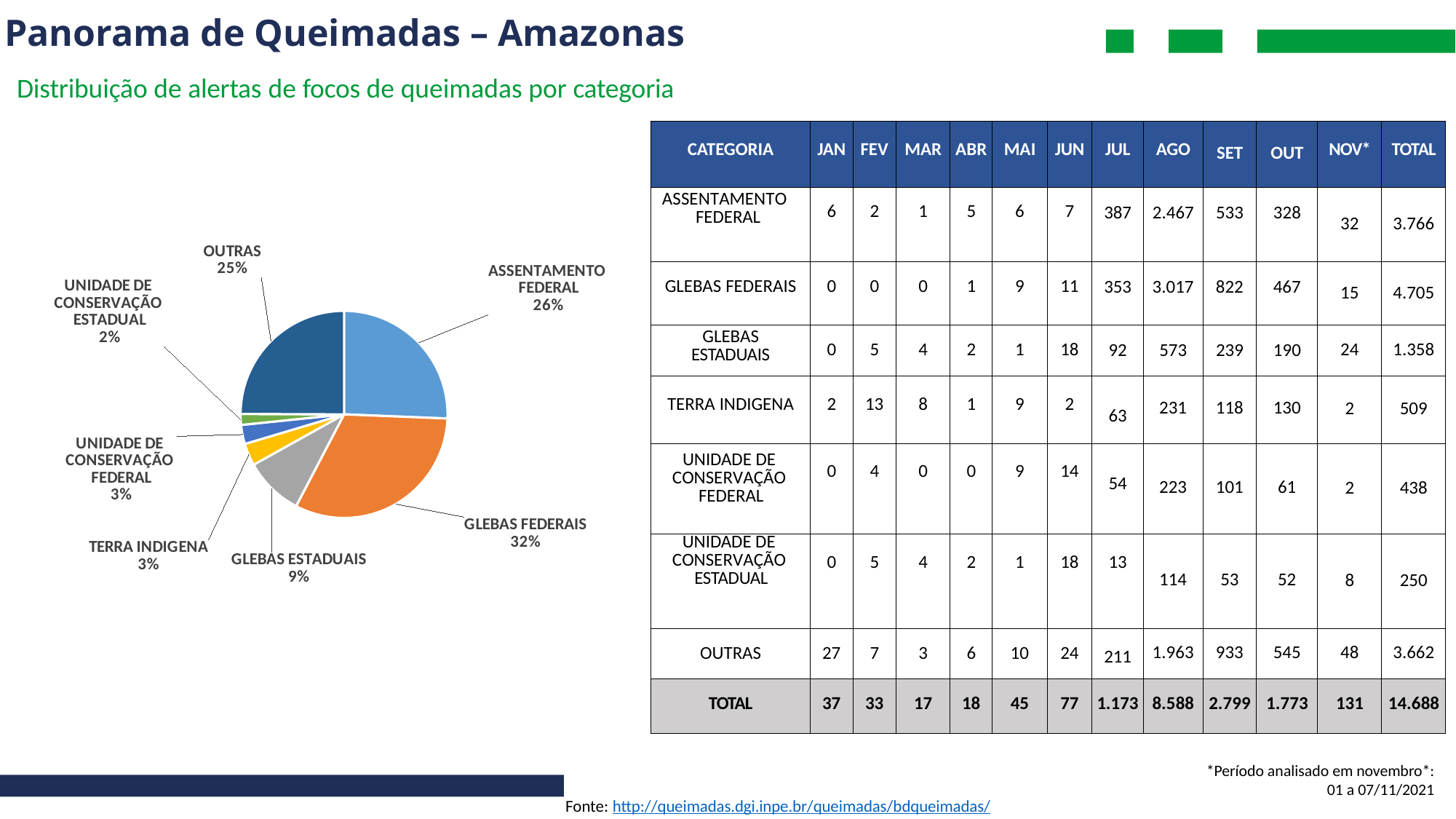
How many categories (slices) does the pie chart show? 7 What percentage is shown for OUTRAS in the pie chart? 25% What is the difference in percentage points between GLEBAS FEDERAIS and ASSENTAMENTO FEDERAL in the pie chart? 6 percentage points Which has a larger share in the pie chart, ASSENTAMENTO FEDERAL or OUTRAS? ASSENTAMENTO FEDERAL Which category has the largest slice in the pie chart? GLEBAS FEDERAIS Which category has the smallest slice in the pie chart? UNIDADE DE CONSERVAÇÃO ESTADUAL What share of the pie chart does ASSENTAMENTO FEDERAL represent? 26% What percentage is shown for UNIDADE DE CONSERVAÇÃO ESTADUAL in the pie chart? 2% What kind of chart is shown on the slide? Pie chart What share of the pie chart does GLEBAS FEDERAIS represent? 32% What is the subtitle describing the pie chart on the slide? Distribuição de alertas de focos de queimadas por categoria What percentage is shown for GLEBAS ESTADUAIS in the pie chart? 9%